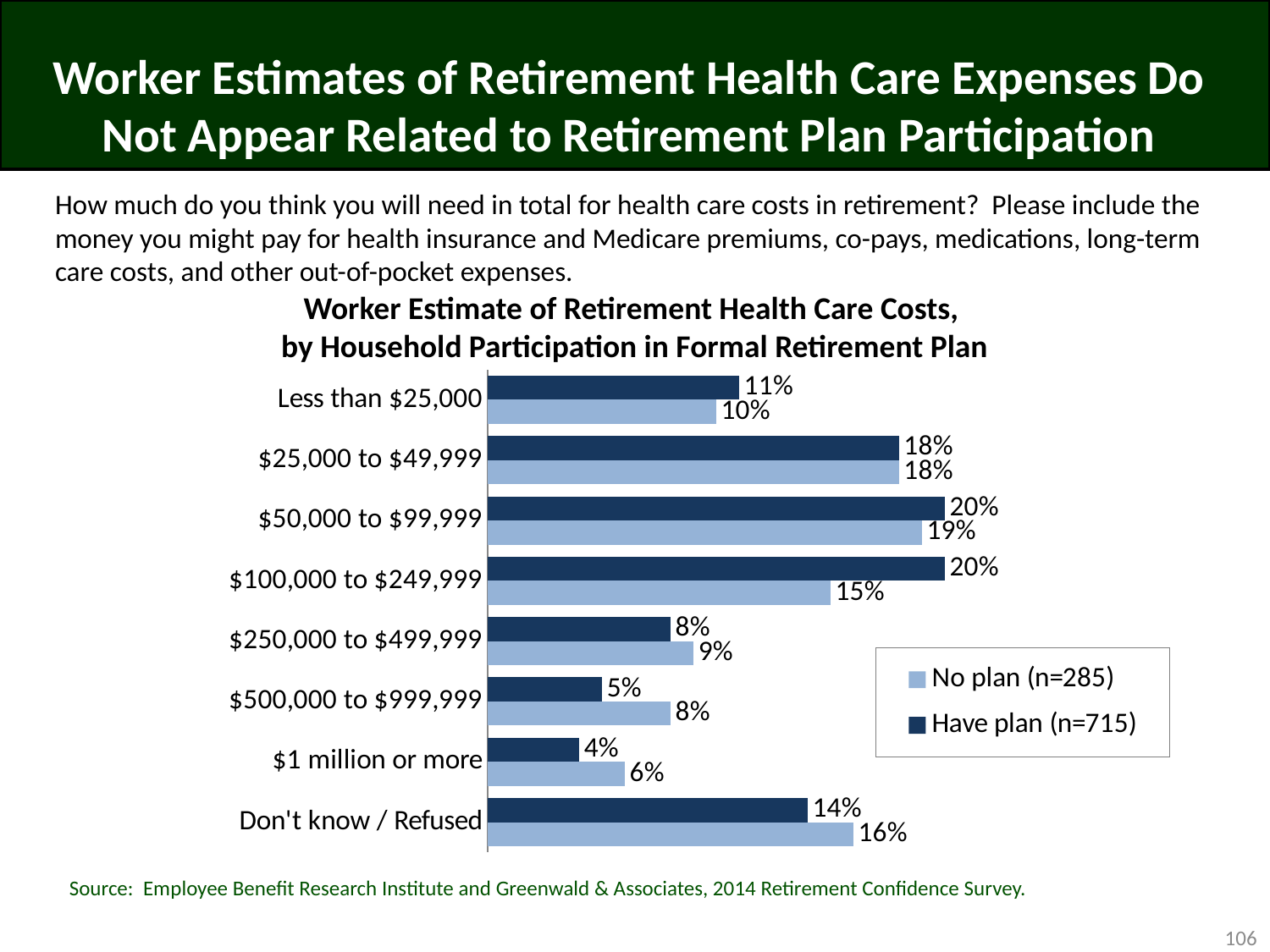
What kind of chart is shown on the slide? bar chart What is the difference between the No plan and Have plan values in the $500,000 to $999,999 category? 3% Which category has the lowest value for Have plan? $1 million or more What sample size does the legend give for the Have plan series? n=715 Which category has the highest value for No plan? $50,000 to $99,999 How many categories are shown on the chart? 8 In the $1 million or more category, which is larger, the Have plan value or the No plan value? No plan What is the value for No plan in the Don't know / Refused category? 16% What is the difference between the Have plan and No plan values in the $100,000 to $249,999 category? 5% What is the value for No plan in the $500,000 to $999,999 category? 8% What is the value for Have plan in the $100,000 to $249,999 category? 20% How many series does the legend list? 2